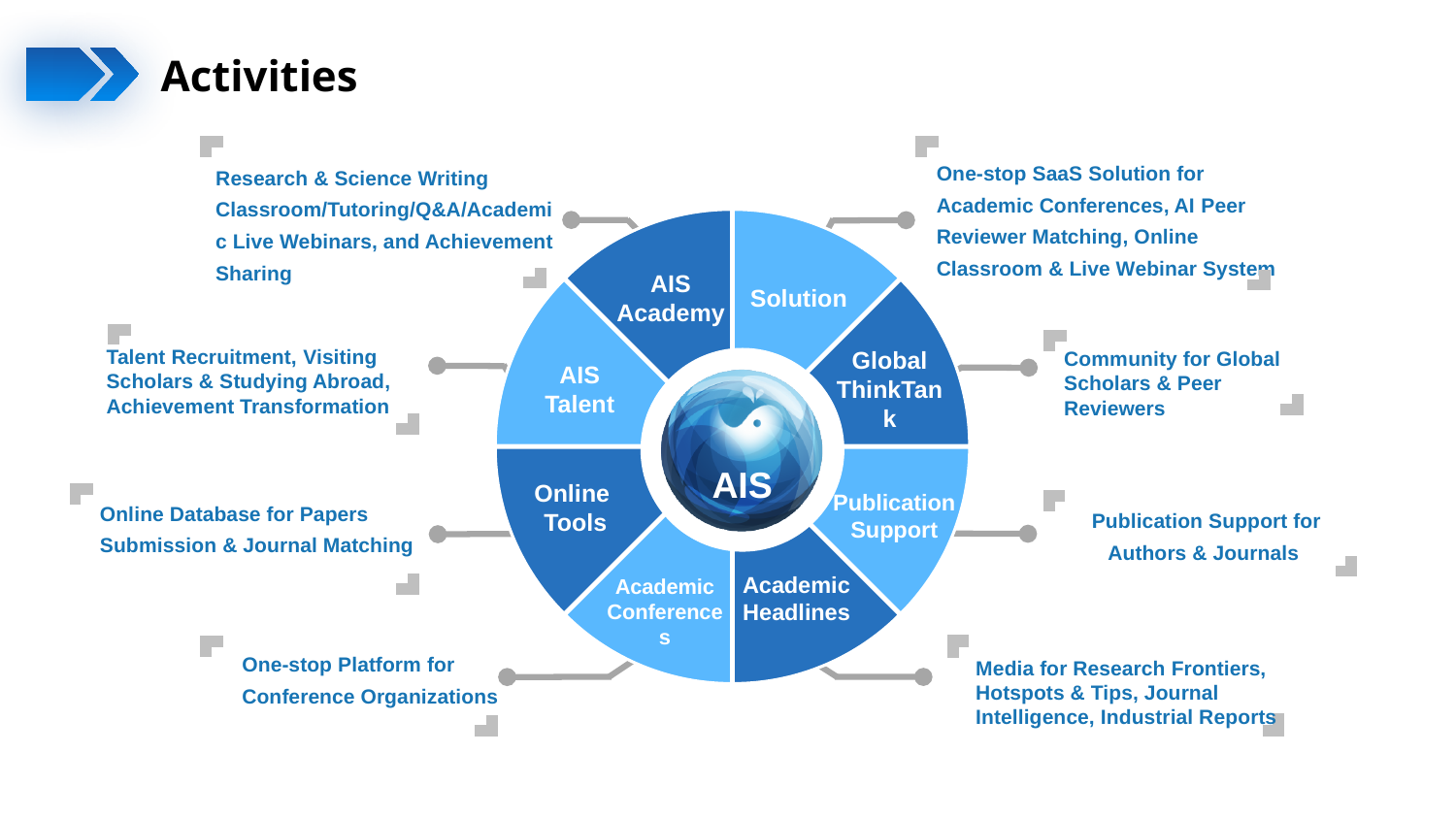
What label appears in the centre of the circular diagram? AIS Which segment of the circular diagram is described as 'Media for Research Frontiers, Hotspots & Tips, Journal Intelligence, Industrial Reports'? Academic Headlines Which segment of the circular diagram is described as 'Community for Global Scholars & Peer Reviewers'? Global ThinkTank Which segment of the circular diagram is described as 'One-stop Platform for Conference Organizations'? Academic Conferences Which segment of the circular diagram is described as 'Talent Recruitment, Visiting Scholars & Studying Abroad, Achievement Transformation'? AIS Talent Which segment of the circular diagram is described as 'Publication Support for Authors & Journals'? Publication Support How many segments does the circular diagram have? 8 Which segment of the circular diagram is described as 'Online Database for Papers Submission & Journal Matching'? Online Tools